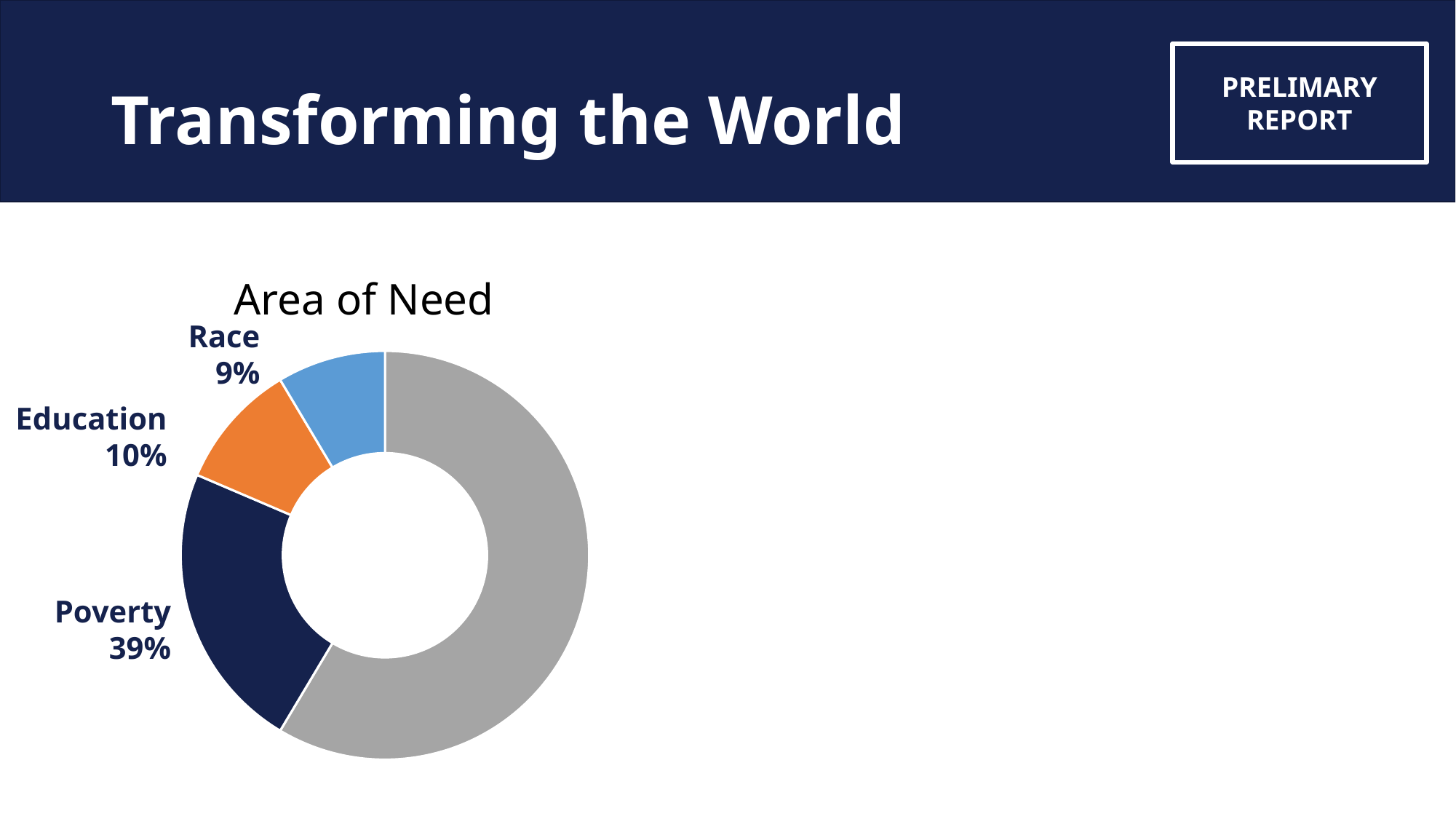
What percentage does the Poverty slice represent in the Area of Need chart? 39% What is the title of the chart on the slide? Area of Need What kind of chart is used to show Area of Need? Doughnut chart What is the difference in percentage points between Education and Race in the Area of Need chart? 1 percentage point Which is larger in the Area of Need chart, Poverty or Education? Poverty What colour is the Education slice in the Area of Need chart? Orange What percentage is shown for Education in the Area of Need chart? 10% What percentage is shown for Race in the Area of Need chart? 9% How many percentage points larger is Poverty than Education in the Area of Need chart? 29 percentage points Which labelled category has the smallest share in the Area of Need chart? Race Which is larger in the Area of Need chart, Education or Race? Education How many slices does the Area of Need chart have? 4